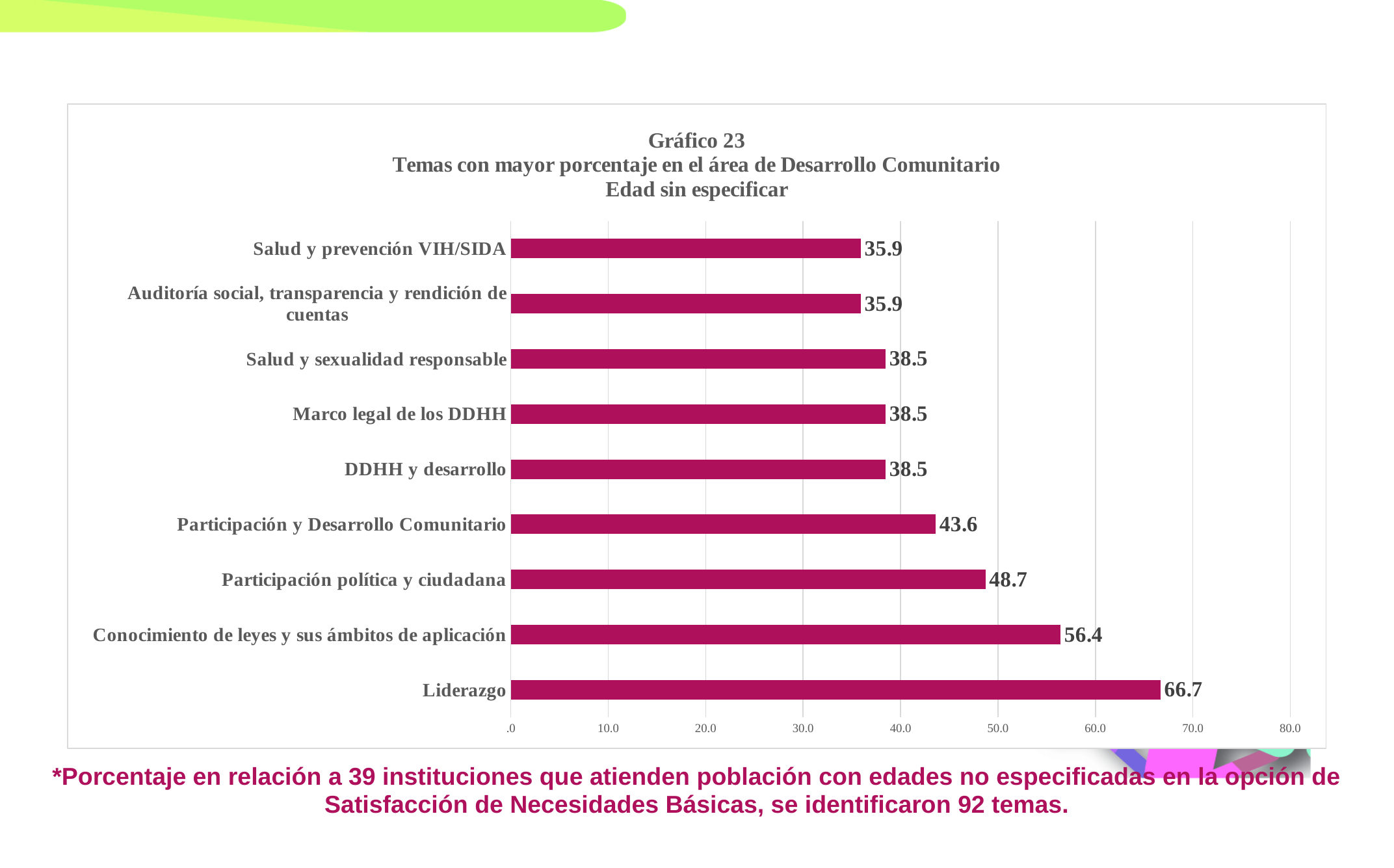
What is the difference between the values for Liderazgo and Conocimiento de leyes y sus ámbitos de aplicación? 10.3 What is the value for Conocimiento de leyes y sus ámbitos de aplicación? 56.4 What is the value for Participación política y ciudadana? 48.7 What is the value for Participación y Desarrollo Comunitario? 43.6 What kind of chart is shown on the slide? bar chart What is the difference between the values for Marco legal de los DDHH and Salud y prevención VIH/SIDA? 2.6 What is the chart number given in the chart title? Gráfico 23 How many categories are shown in the chart? 9 Which category has the highest value? Liderazgo Which is larger, the value for Participación política y ciudadana or the value for Participación y Desarrollo Comunitario? Participación política y ciudadana Is the value for Salud y sexualidad responsable greater or less than 40.0? less What is the value for Liderazgo? 66.7